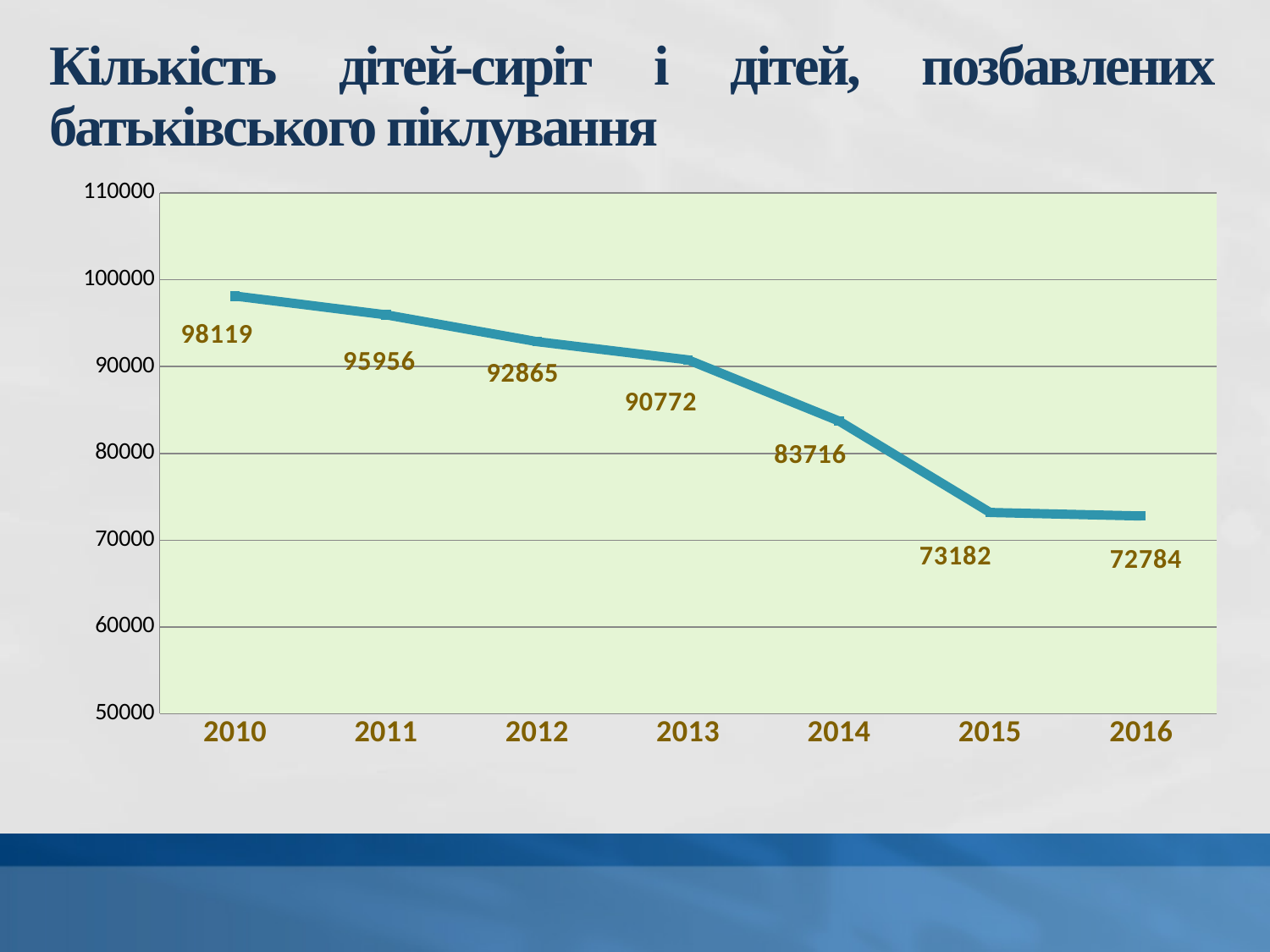
What is the difference between the values for 2014 and 2015? 10534 Is the value for 2014 greater or less than 80000? greater What is the difference between the values for 2010 and 2016? 25335 What kind of chart is shown on the slide? line chart How many years are plotted on the chart? 7 What is the value for 2016? 72784 What is the value for 2010? 98119 Do the values rise or fall from 2010 to 2016? fall What is the value for 2013? 90772 Which year has the lowest value? 2016 Which year has the highest value? 2010 Which is larger, the value for 2011 or the value for 2012? 2011